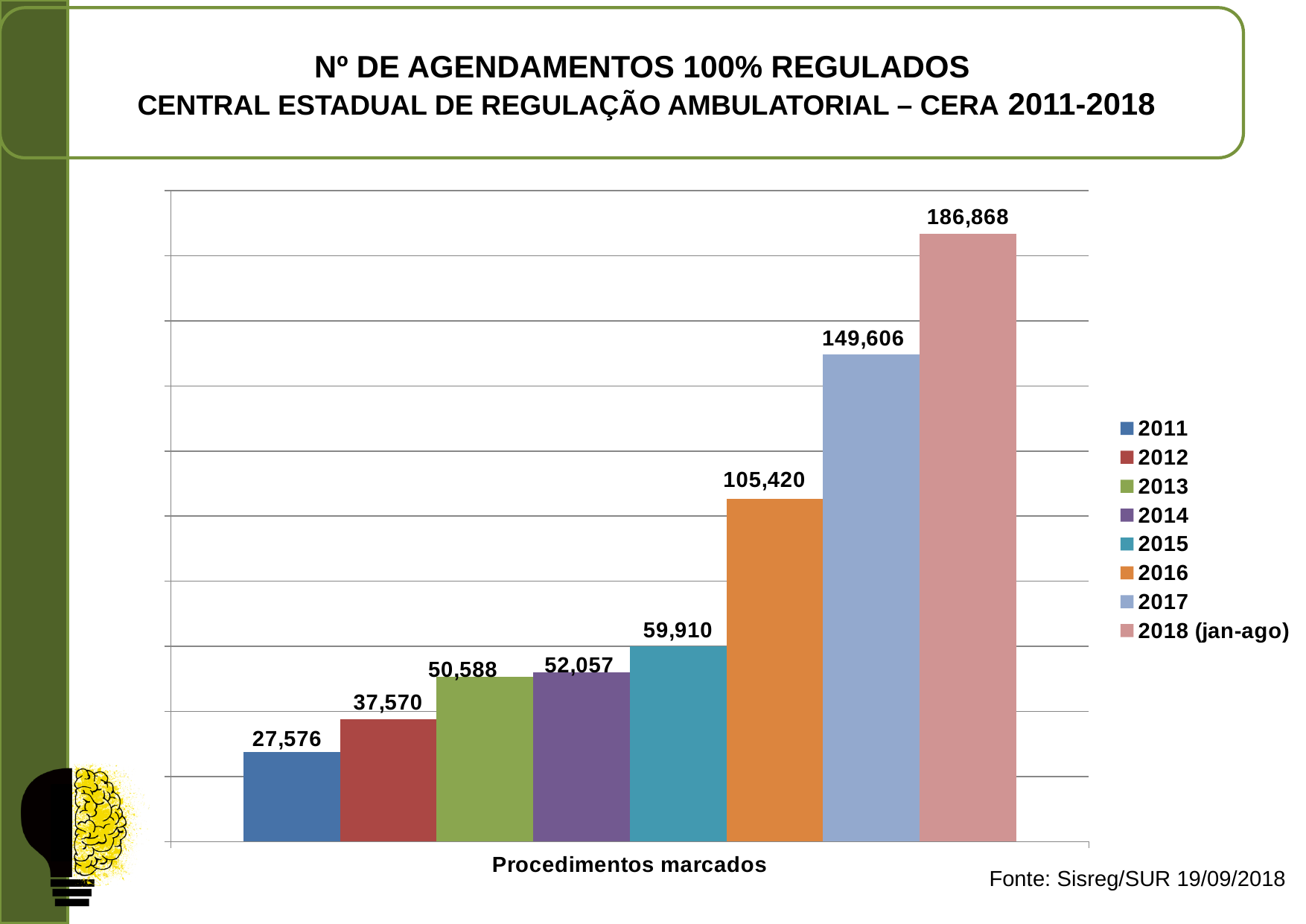
How many series does the legend list? 8 What kind of chart is shown on the slide? Bar chart Which year has the highest value in the chart? 2018 (jan-ago) What is the label shown on the x axis of the chart? Procedimentos marcados What is the value for 2011 in the chart? 27,576 What is the value for 2016 in the chart? 105,420 Which is larger, the value for 2013 or the value for 2015? 2015 What is the value for 2018 (jan-ago) in the chart? 186,868 Do the values rise or fall from 2011 to 2018 (jan-ago)? Rise What is the difference between the values for 2017 and 2016? 44,186 Which year has the lowest value in the chart? 2011 What is the difference between the values for 2018 (jan-ago) and 2017? 37,262